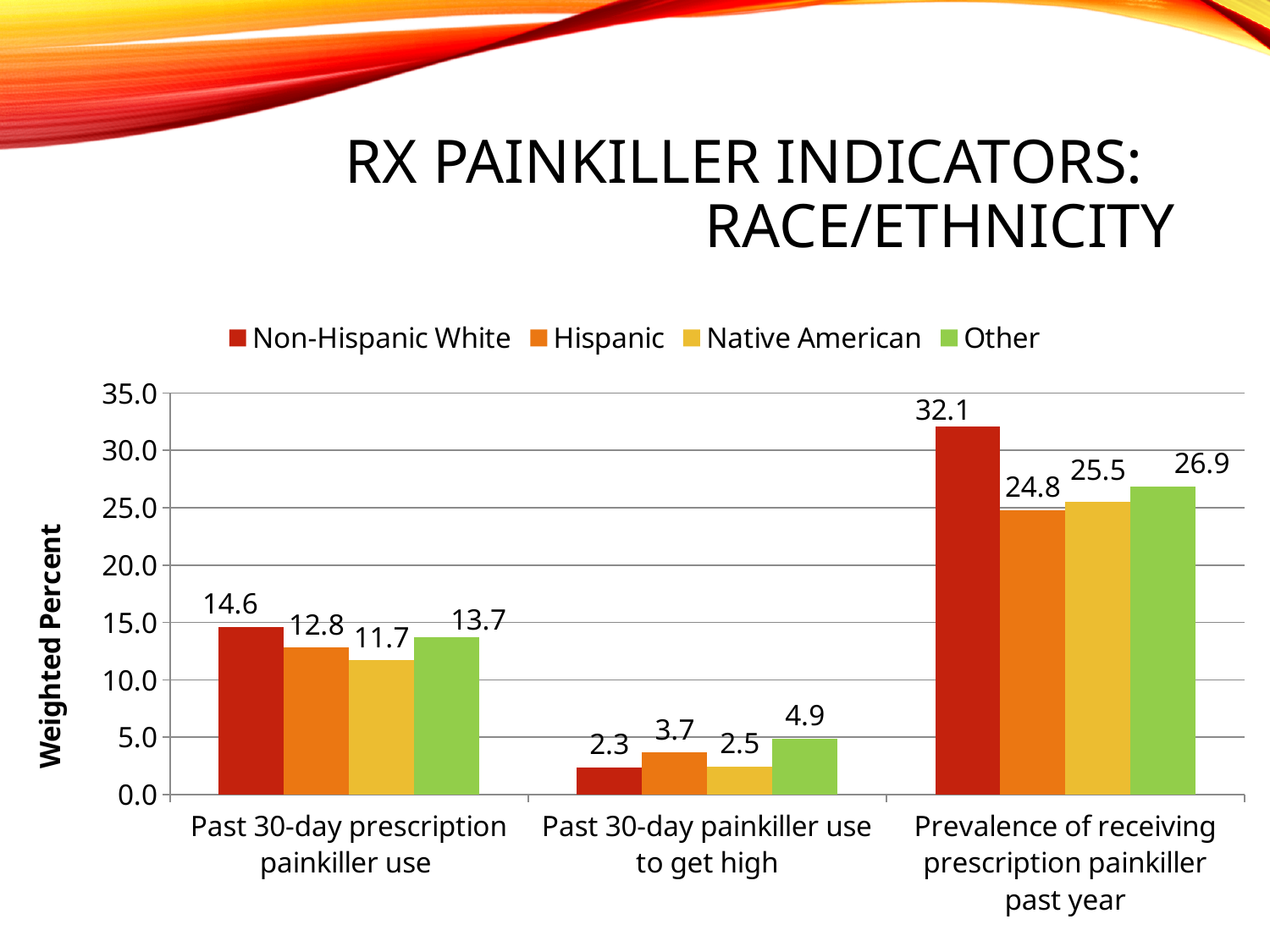
In the 'Past 30-day painkiller use to get high' category, which is larger: the Hispanic value or the Native American value? Hispanic What is the label of the y axis? Weighted Percent What kind of chart is shown on the slide? Bar chart What is the difference between the Non-Hispanic White and Hispanic values in the 'Prevalence of receiving prescription painkiller past year' category? 7.3 Is the value for Other in the 'Prevalence of receiving prescription painkiller past year' category greater or less than 25.0? greater Which group has the lowest value in the 'Past 30-day prescription painkiller use' category? Native American How many series does the legend list? 4 Which group has the highest value in the 'Prevalence of receiving prescription painkiller past year' category? Non-Hispanic White What is the value for Hispanic in the 'Prevalence of receiving prescription painkiller past year' category? 24.8 How many categories are shown on the x axis? 3 What is the value for Non-Hispanic White in the 'Past 30-day prescription painkiller use' category? 14.6 What is the value for Other in the 'Past 30-day painkiller use to get high' category? 4.9